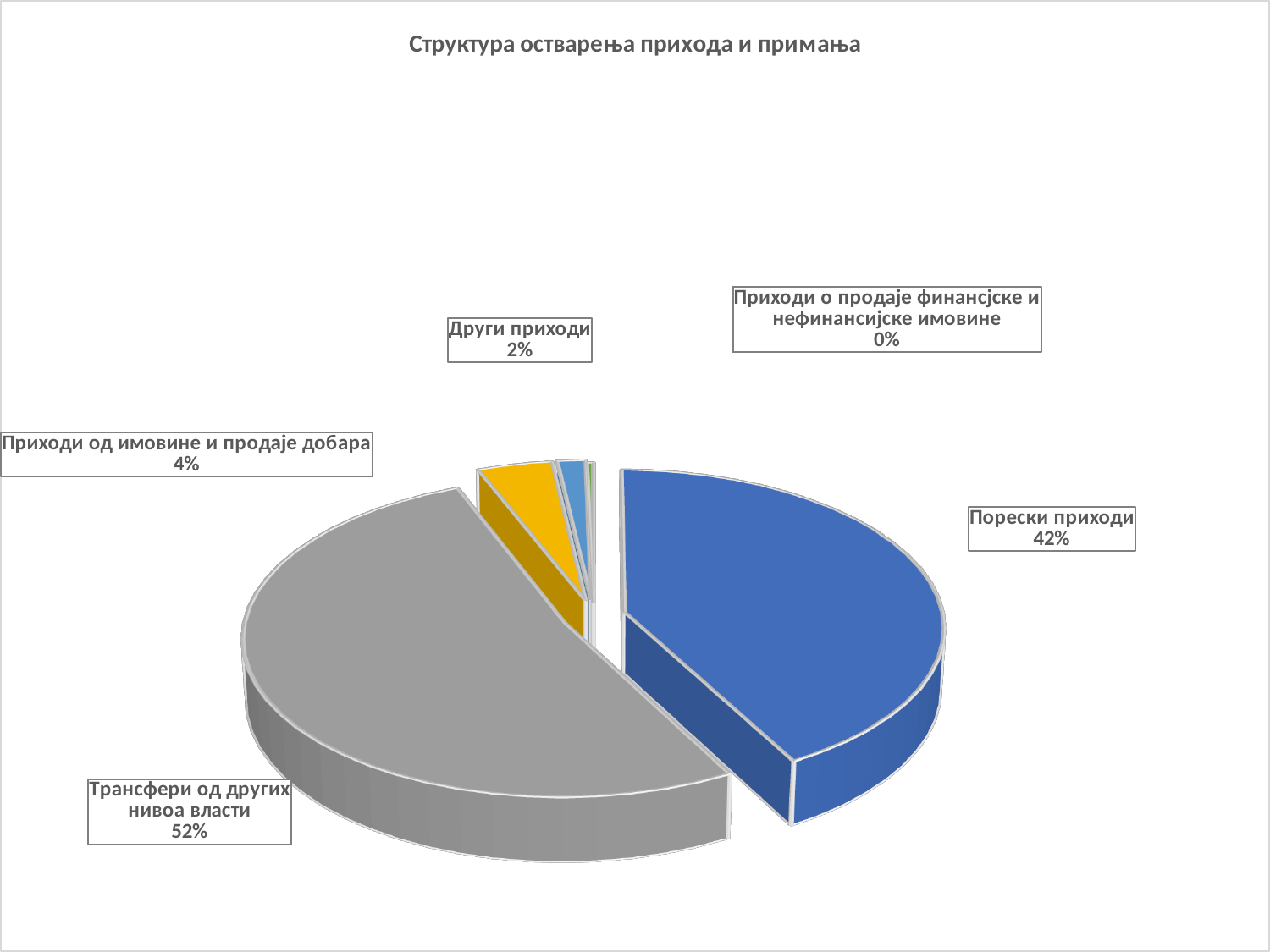
What is the difference in percentage points between "Трансфери од других нивоа власти" and "Порески приходи"? 10 percentage points Which is larger: the share for "Приходи од имовине и продаје добара" or the share for "Други приходи"? Приходи од имовине и продаје добара What share of the pie is "Порески приходи"? 42% Which category has the largest share of the pie? Трансфери од других нивоа власти What is the title of the chart? Структура остварења прихода и примања How many slices does the pie chart have? 5 What share of the pie is "Приходи о продаје финансјске и нефинансијске имовине"? 0% Which category has the smallest share of the pie? Приходи о продаје финансјске и нефинансијске имовине What share of the pie is "Трансфери од других нивоа власти"? 52% What kind of chart is shown on the slide? pie chart